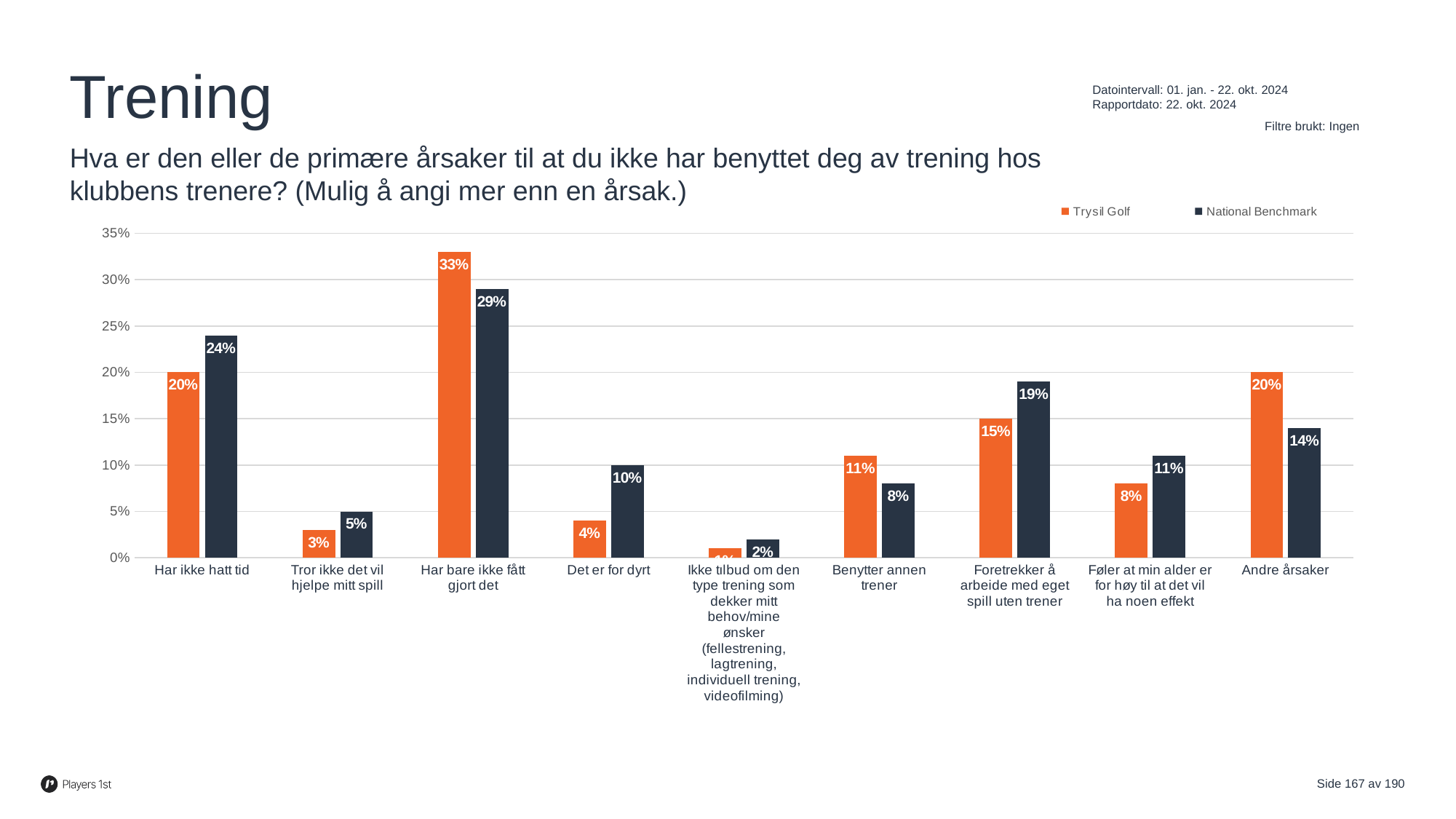
What kind of chart is shown on the slide? Bar chart Is the National Benchmark value for "Har bare ikke fått gjort det" greater or less than 25%? greater How many categories are shown on the x axis? 9 Which colour represents Trysil Golf in the chart? Orange Which category has the highest Trysil Golf value? Har bare ikke fått gjort det How many series does the legend list? 2 What is the difference between the National Benchmark and Trysil Golf values for "Har ikke hatt tid"? 4% What is the Trysil Golf value for "Andre årsaker"? 20% For "Foretrekker å arbeide med eget spill uten trener", which series has the larger value, Trysil Golf or National Benchmark? National Benchmark What is the National Benchmark value for "Det er for dyrt"? 10% Which category has the lowest National Benchmark value? Ikke tilbud om den type trening som dekker mitt behov/mine ønsker (fellestrening, lagtrening, individuell trening, videofilming) What is the Trysil Golf value for "Har bare ikke fått gjort det"? 33%